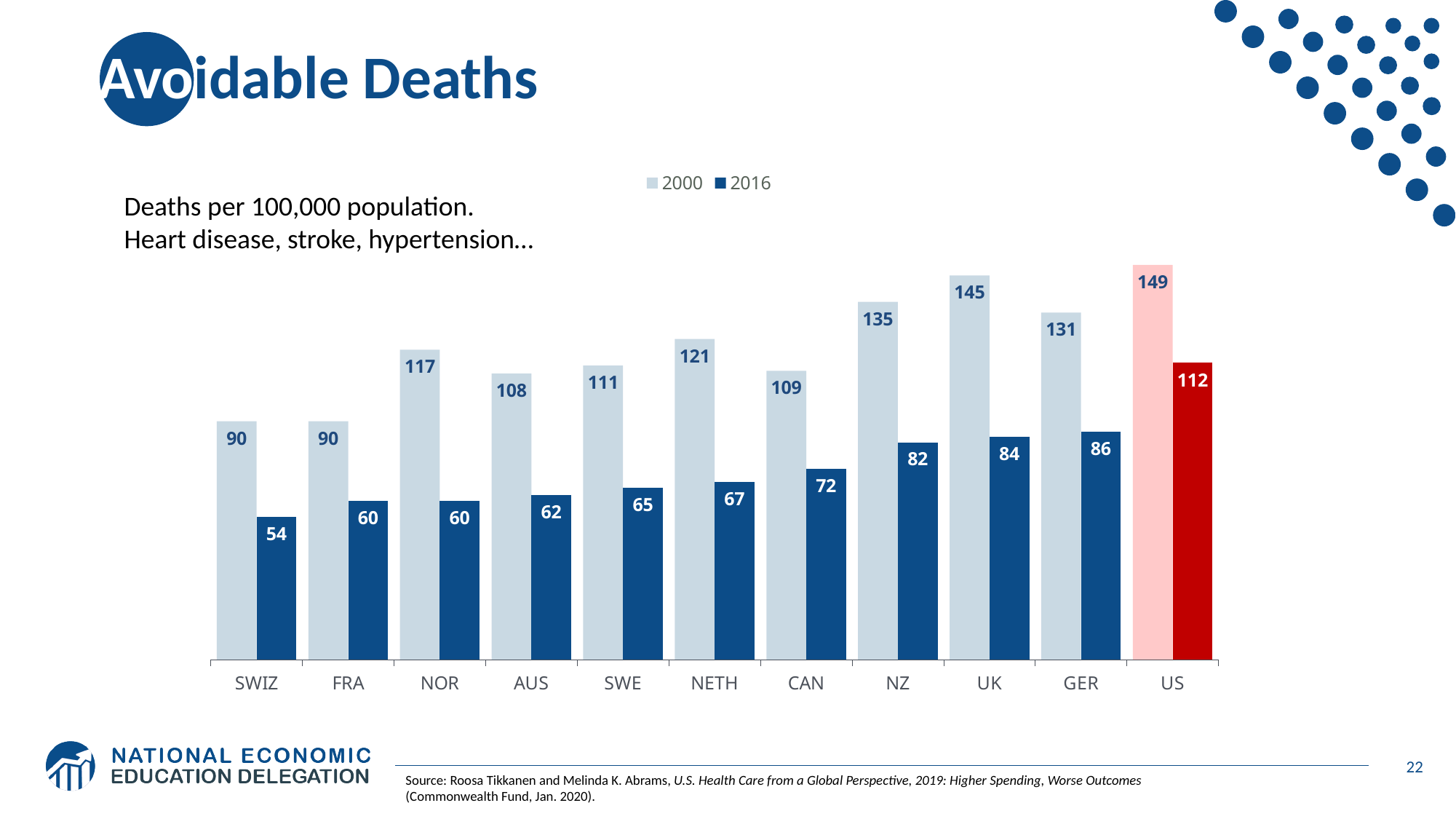
Which country had the highest value in 2016? US What was the value for Switzerland (SWIZ) in 2016? 54 What was the value for the UK in 2000? 145 What kind of chart is shown on the slide? Bar chart What was the value for the US in 2000? 149 What is the difference between the US values for 2000 and 2016? 37 Which years are listed in the chart legend? 2000 and 2016 How many series does the legend list? 2 Which is larger: the 2016 value for Germany (GER) or the 2016 value for the UK? GER How many countries are shown on the x axis? 11 Which country had the lowest value in 2016? SWIZ Which two countries had the same value of 90 in 2000? SWIZ and FRA